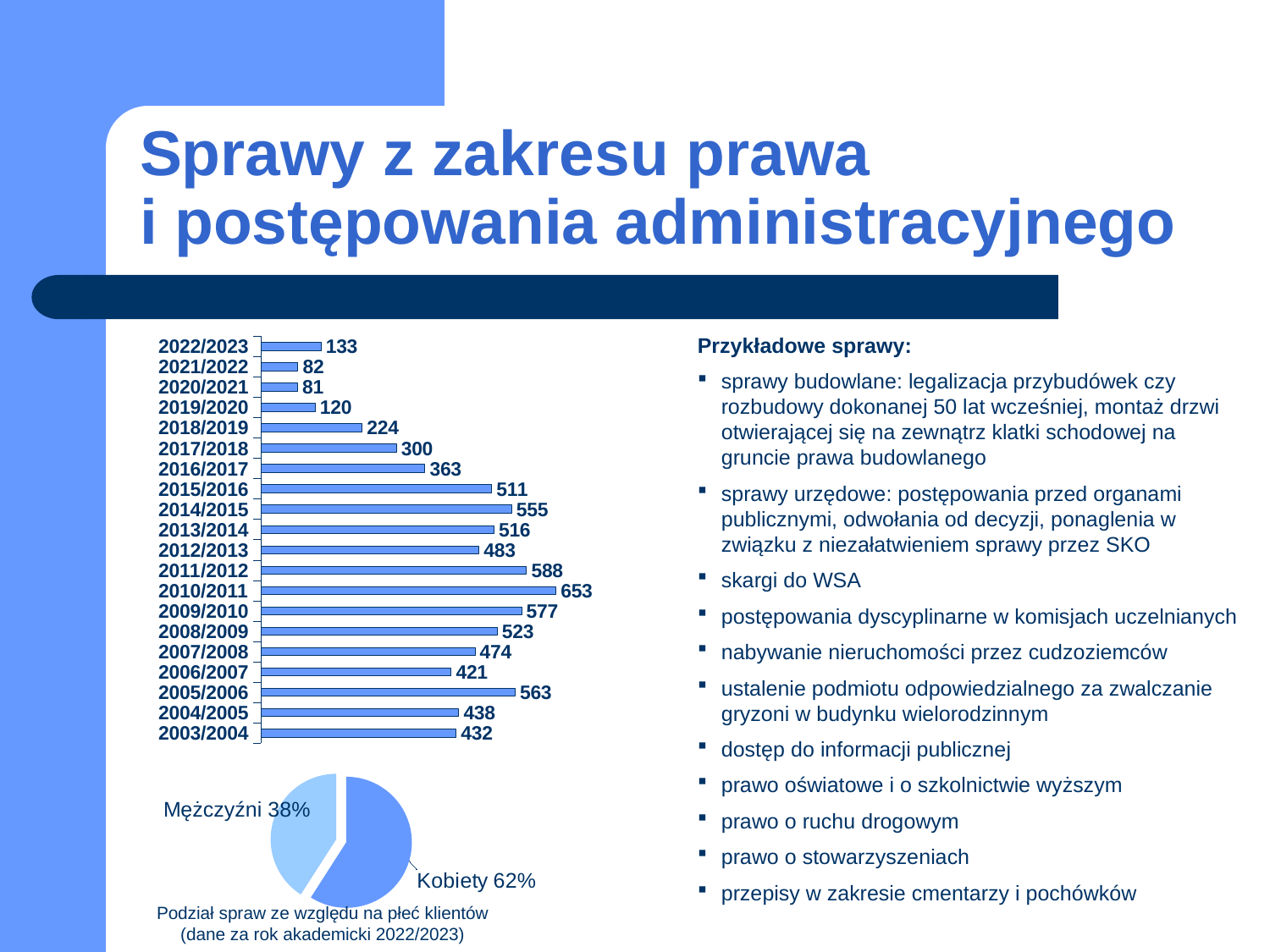
In the bar chart at the top left of the slide, do the values generally rise or fall from 2015/2016 to 2020/2021? fall In the bar chart at the top left of the slide, which academic year has the lowest value? 2020/2021 In the bar chart at the top left of the slide, which academic year has the highest value? 2010/2011 What kind of chart is the chart at the top left of the slide? bar chart What is the caption below the pie chart at the bottom left of the slide? Podział spraw ze względu na płeć klientów (dane za rok akademicki 2022/2023) In the bar chart at the top left of the slide, what is the value for 2022/2023? 133 In the pie chart at the bottom left of the slide, what share is labelled Kobiety? 62% In the bar chart at the top left of the slide, what is the value for 2010/2011? 653 In the bar chart at the top left of the slide, which is larger: the value for 2005/2006 or the value for 2006/2007? 2005/2006 In the bar chart at the top left of the slide, what is the difference between the values for 2011/2012 and 2012/2013? 105 How many academic years are shown in the bar chart at the top left of the slide? 20 In the pie chart at the bottom left of the slide, what share is labelled Mężczyźni? 38%